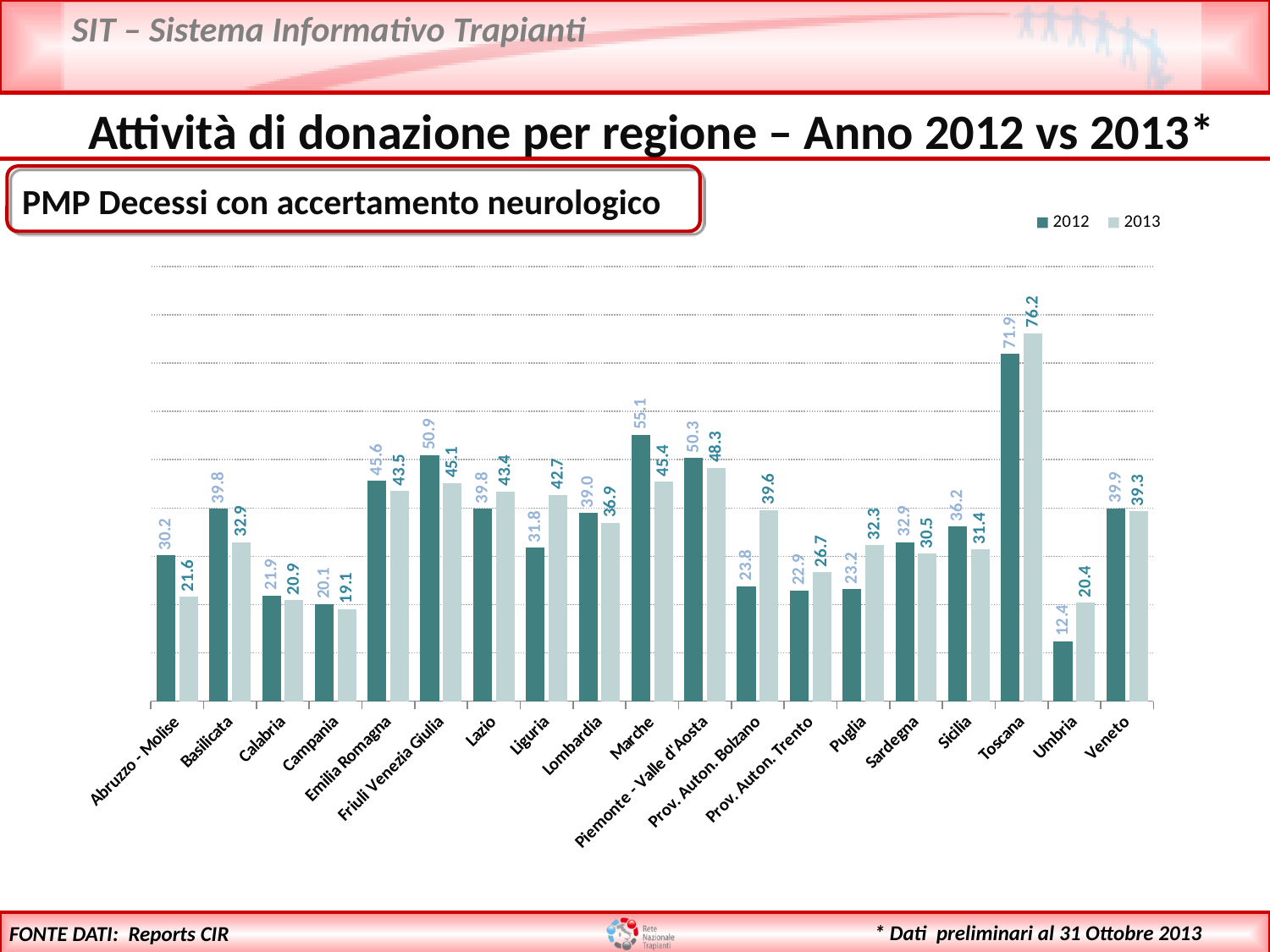
Which is larger for Friuli Venezia Giulia, the 2012 value or the 2013 value? 2012 What is the 2013 value for Umbria? 20.4 Which region has the highest 2013 value? Toscana What is the difference between the 2012 and 2013 values for Marche? 9.7 Which is larger for Liguria, the 2012 value or the 2013 value? 2013 What kind of chart is shown on the slide? Bar chart How many regions are shown on the x axis? 19 What is the 2012 value for Toscana? 71.9 What is the 2013 value for Prov. Auton. Bolzano? 39.6 What is the difference between the 2013 and 2012 values for Toscana? 4.3 Which region has the lowest 2012 value? Umbria How many series does the legend list? 2